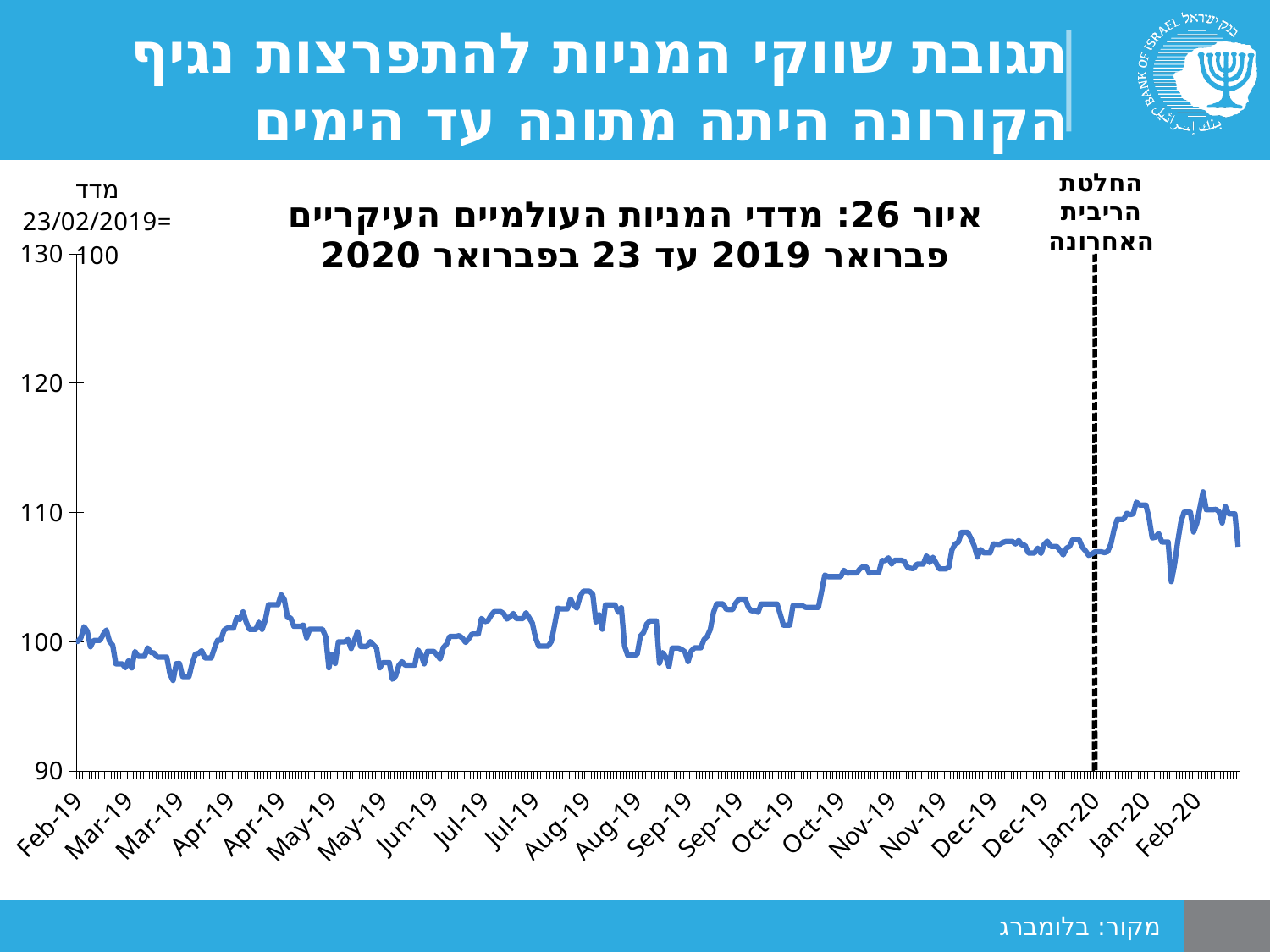
Is the value in Dec-19 greater or less than 120? less Is the value at the end of the series (Feb-20) greater or less than 100? greater Overall, do the values rise or fall from Feb-19 to Feb-20? rise Is the value in Mar-19 greater or less than 110? less What kind of chart is shown on the slide? line chart What is the highest value shown on the vertical axis? 130 What is the title of the chart? איור 26: מדדי המניות העולמיים העיקריים פברואר 2019 עד 23 בפברואר 2020 How many data series are plotted in the chart? 1 Which is larger, the value in Jan-20 or the value in Mar-19? Jan-20